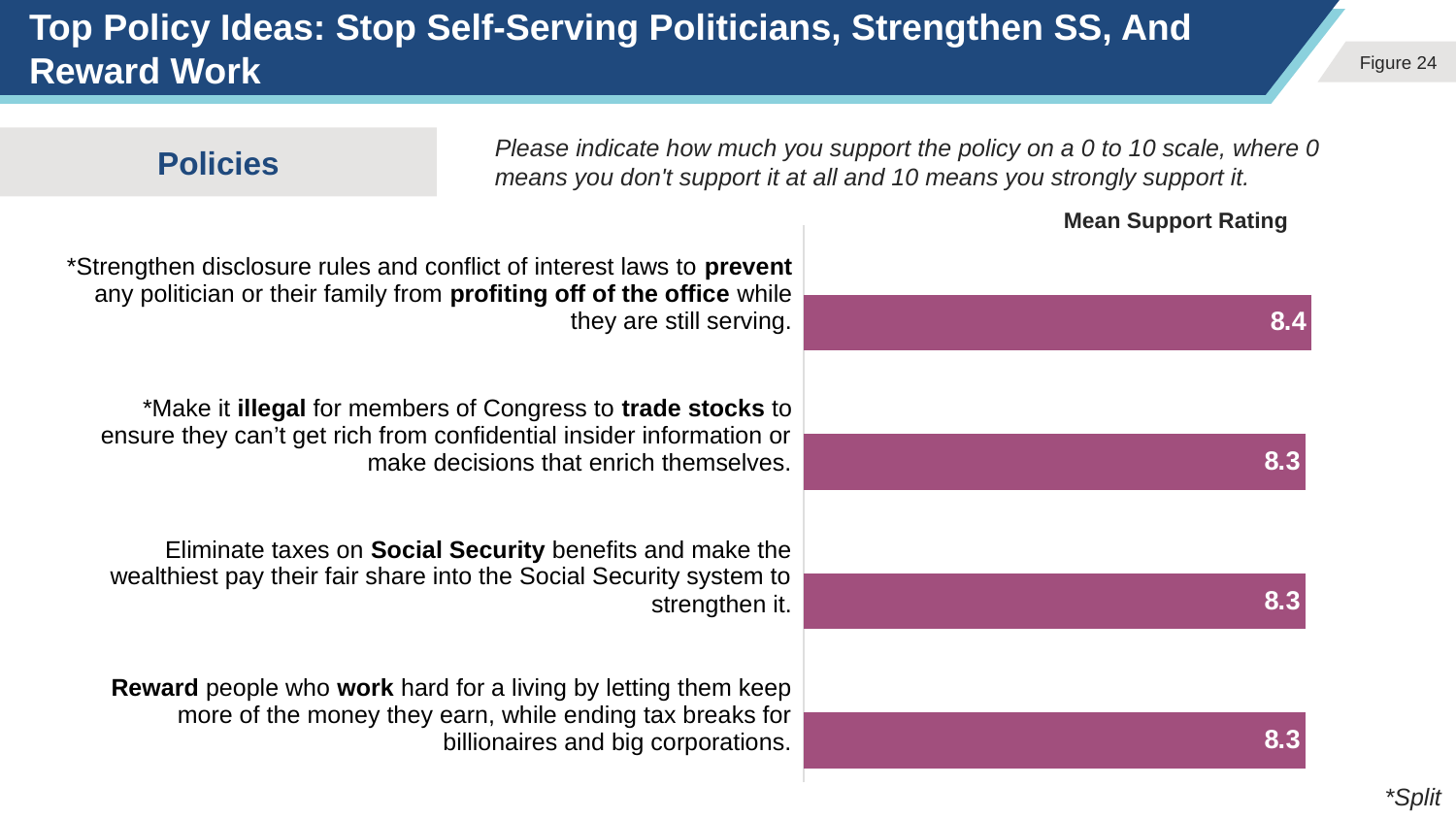
Is the mean support rating for the Social Security policy greater or less than 8? greater What scale were respondents asked to use to rate their support for each policy? 0 to 10 What is the mean support rating for the policy to strengthen disclosure rules and conflict of interest laws to prevent politicians from profiting off of the office? 8.4 What is the label of the value column shown above the bars? Mean Support Rating What is the difference between the mean support rating for strengthening disclosure rules and the rating for making it illegal for members of Congress to trade stocks? 0.1 What is the mean support rating for making it illegal for members of Congress to trade stocks? 8.3 How many policies are shown in the chart? 4 What is the mean support rating for eliminating taxes on Social Security benefits and making the wealthiest pay their fair share? 8.3 Which policy has the highest mean support rating? Strengthen disclosure rules and conflict of interest laws to prevent any politician or their family from profiting off of the office What type of chart is used to show the mean support ratings? Bar chart What is the mean support rating for rewarding people who work hard by letting them keep more of the money they earn? 8.3